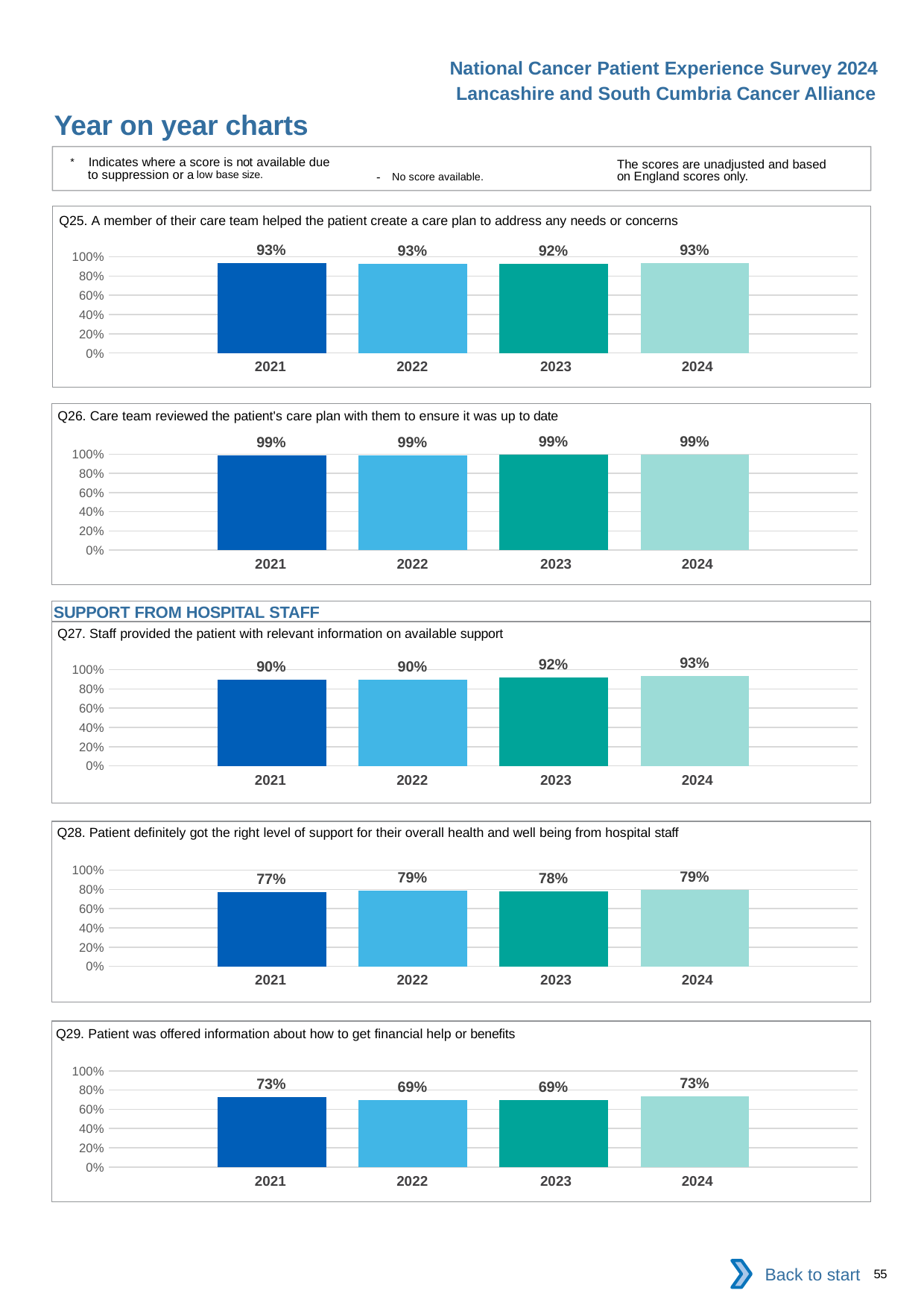
What kind of chart is the Q25 chart? Bar chart In the Q28 chart, which year has the lowest value? 2021 In the Q28 chart, is the value for 2022 greater or less than 60%? greater In the Q27 chart, which year has the highest value? 2024 How many charts are shown on the slide? 5 In the Q25 chart, what is the value for 2023? 92% In the Q27 chart, is the value for 2021 or 2024 larger? 2024 In the Q29 chart, what is the value for 2024? 73% In the Q27 chart, do the values rise or fall from 2021 to 2024? Rise How many years are shown in the Q29 chart? 4 In the Q26 chart, what is the value for 2024? 99% In the Q29 chart, what is the difference between the 2021 value and the 2022 value? 4%